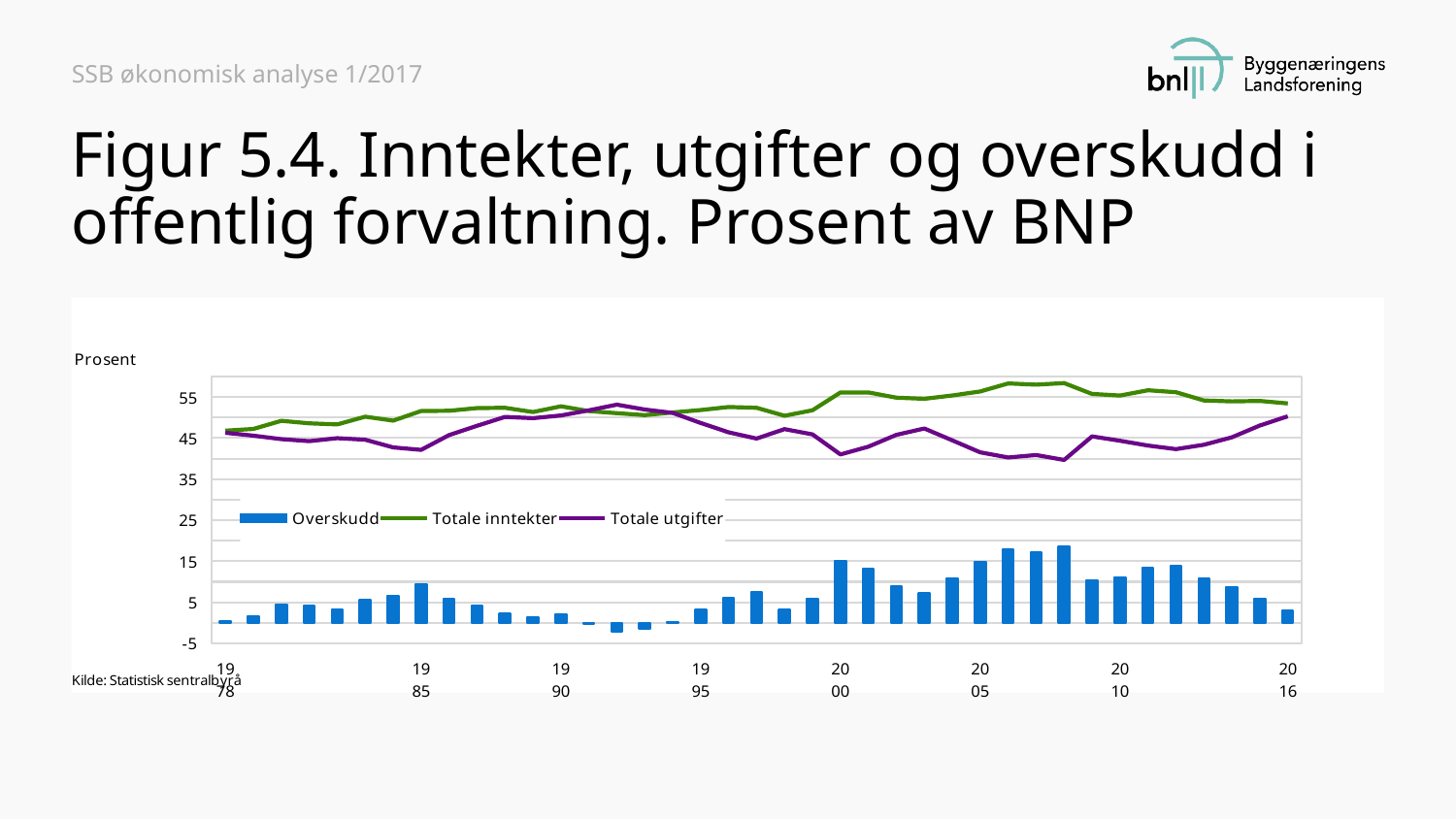
Is the Overskudd value in 2000 greater or less than 5? greater Is the Overskudd value in 1978 greater or less than 5? less How many series does the chart legend list? 3 What kind of chart is shown on the slide? Combined bar and line chart Which series is plotted as bars rather than a line? Overskudd Is the value of Totale inntekter in 2016 greater or less than 45? greater Does the Totale inntekter line rise or fall overall from 1978 to 2016? rise In 2005, which is higher, Totale inntekter or Totale utgifter? Totale inntekter Which series are listed in the chart legend? Overskudd, Totale inntekter, Totale utgifter How many year labels are shown on the x axis? 8